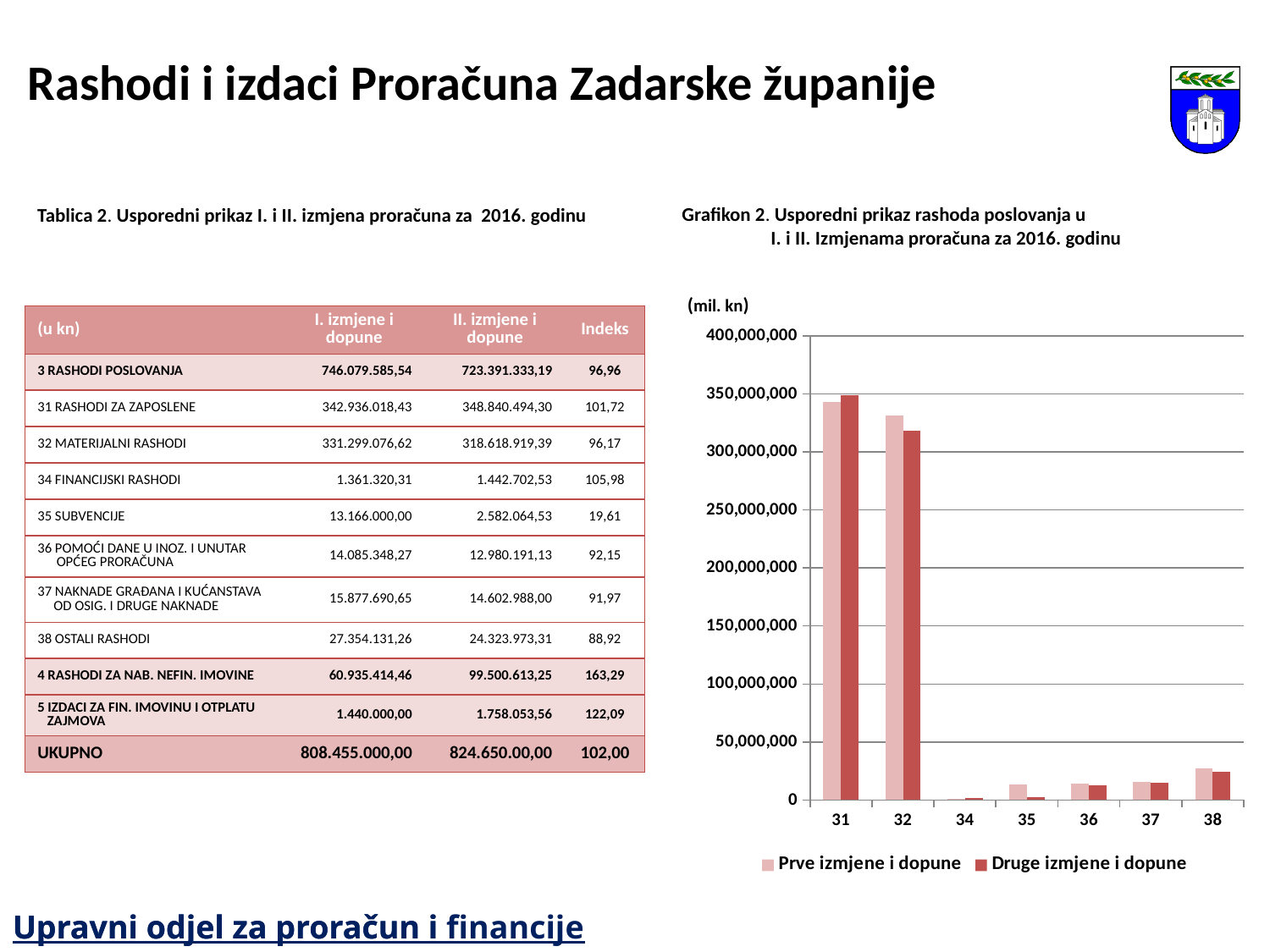
In Grafikon 2, for category 32, which series has the larger value: Prve izmjene i dopune or Druge izmjene i dopune? Prve izmjene i dopune Which category has the highest value for Druge izmjene i dopune in Grafikon 2? 31 In Grafikon 2, is the Prve izmjene i dopune value for category 31 greater or less than 300,000,000? greater How many series does the legend of Grafikon 2 list? 2 In Grafikon 2, which is larger for Prve izmjene i dopune: category 31 or category 38? 31 What unit label is shown above the y axis of Grafikon 2? (mil. kn) How many categories are shown on the x axis of Grafikon 2? 7 What kind of chart is Grafikon 2? bar chart In Grafikon 2, is the Prve izmjene i dopune value for category 38 greater or less than 50,000,000? less Which category has the highest value for Prve izmjene i dopune in Grafikon 2? 31 Which category has the lowest value for Prve izmjene i dopune in Grafikon 2? 34 In Grafikon 2, is the Druge izmjene i dopune value for category 32 greater or less than 300,000,000? greater